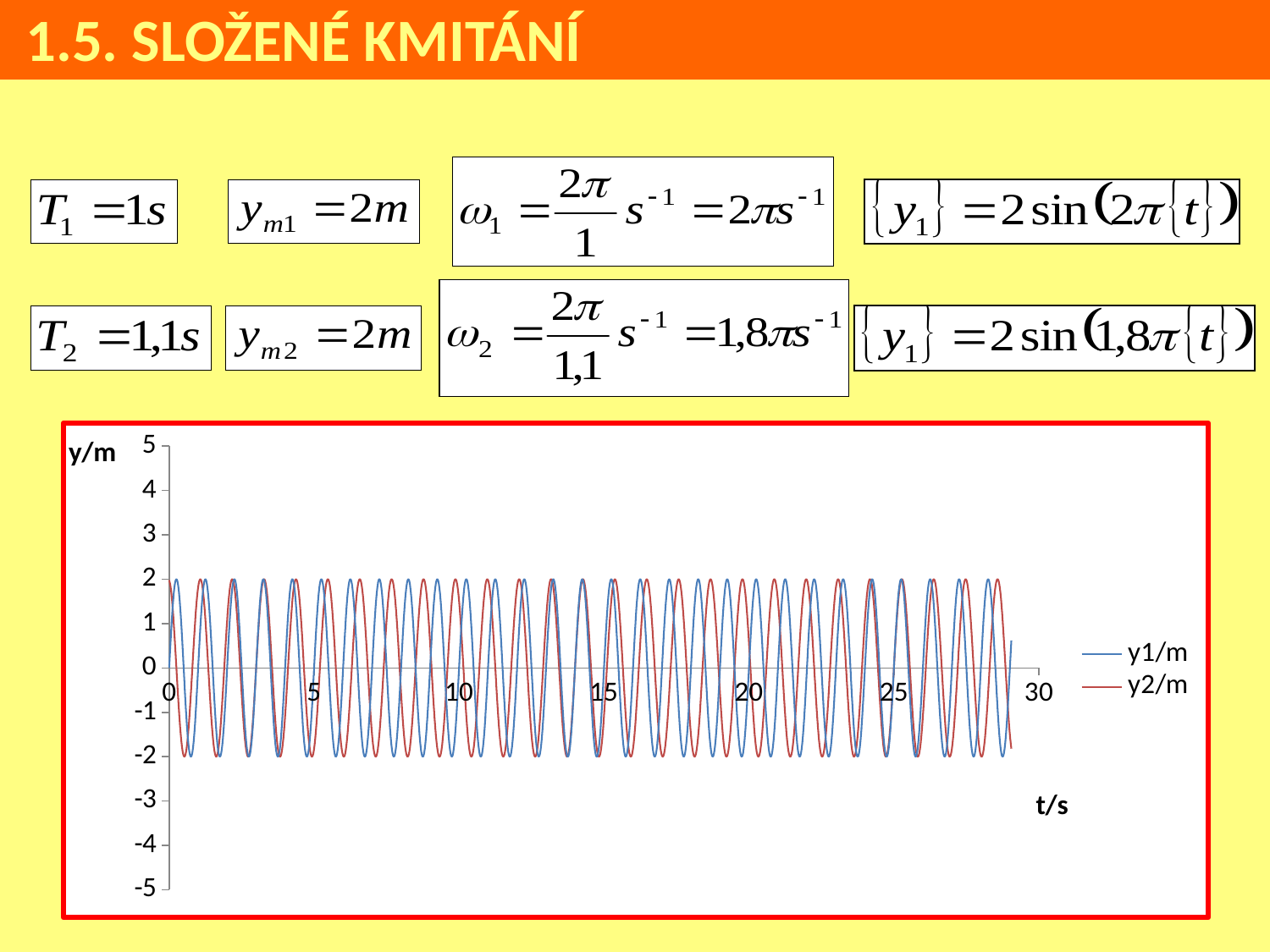
What kind of chart is shown on the slide? line chart Is the peak value of the y2/m series greater or less than 3? less How many series does the chart legend list? 2 What is the difference between the maximum and minimum values of the y1/m series? 4 What is the largest tick value shown on the horizontal axis of the chart? 30 Which colour is used for the y1/m series in the chart? blue What is the highest tick value shown on the vertical axis of the chart? 5 What is the maximum value reached by the y1/m series on the chart? 2 Do the values of the y1/m series steadily rise, steadily fall, or oscillate along the x axis? oscillate What are the two series named in the chart legend? y1/m and y2/m Is the lowest value of the y1/m series greater or less than -3? greater